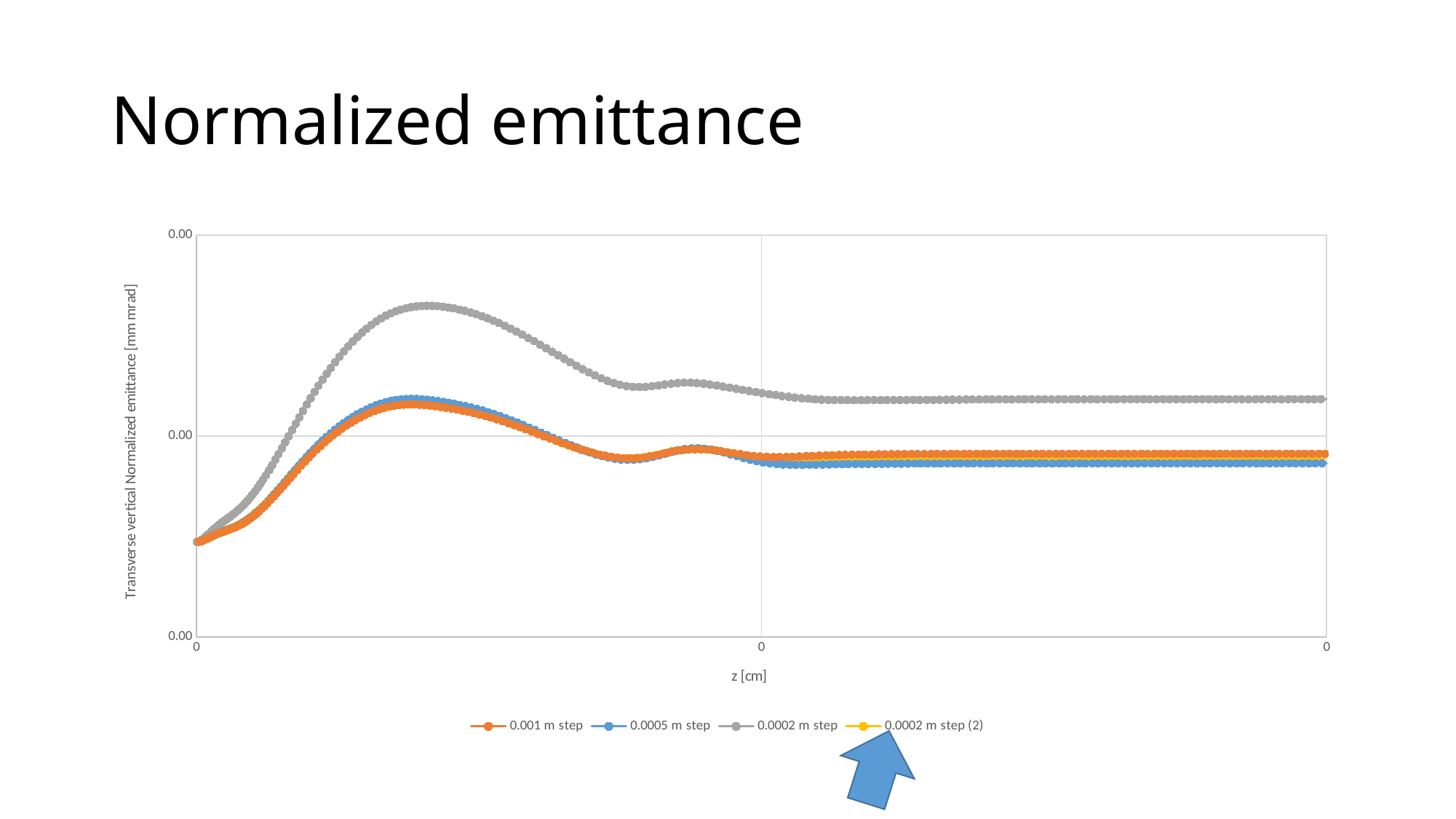
Which series is plotted in blue? 0.0005 m step How many series does the legend list? 4 What is the label of the x axis? z [cm] What kind of chart is shown on the slide? line chart At the right end of the chart, which series has the larger value: 0.0002 m step or 0.001 m step? 0.0002 m step Which series is plotted in gray? 0.0002 m step Which series reaches the highest peak value? 0.0002 m step At the right end of the chart, which series has the larger value: 0.001 m step or 0.0005 m step? 0.001 m step